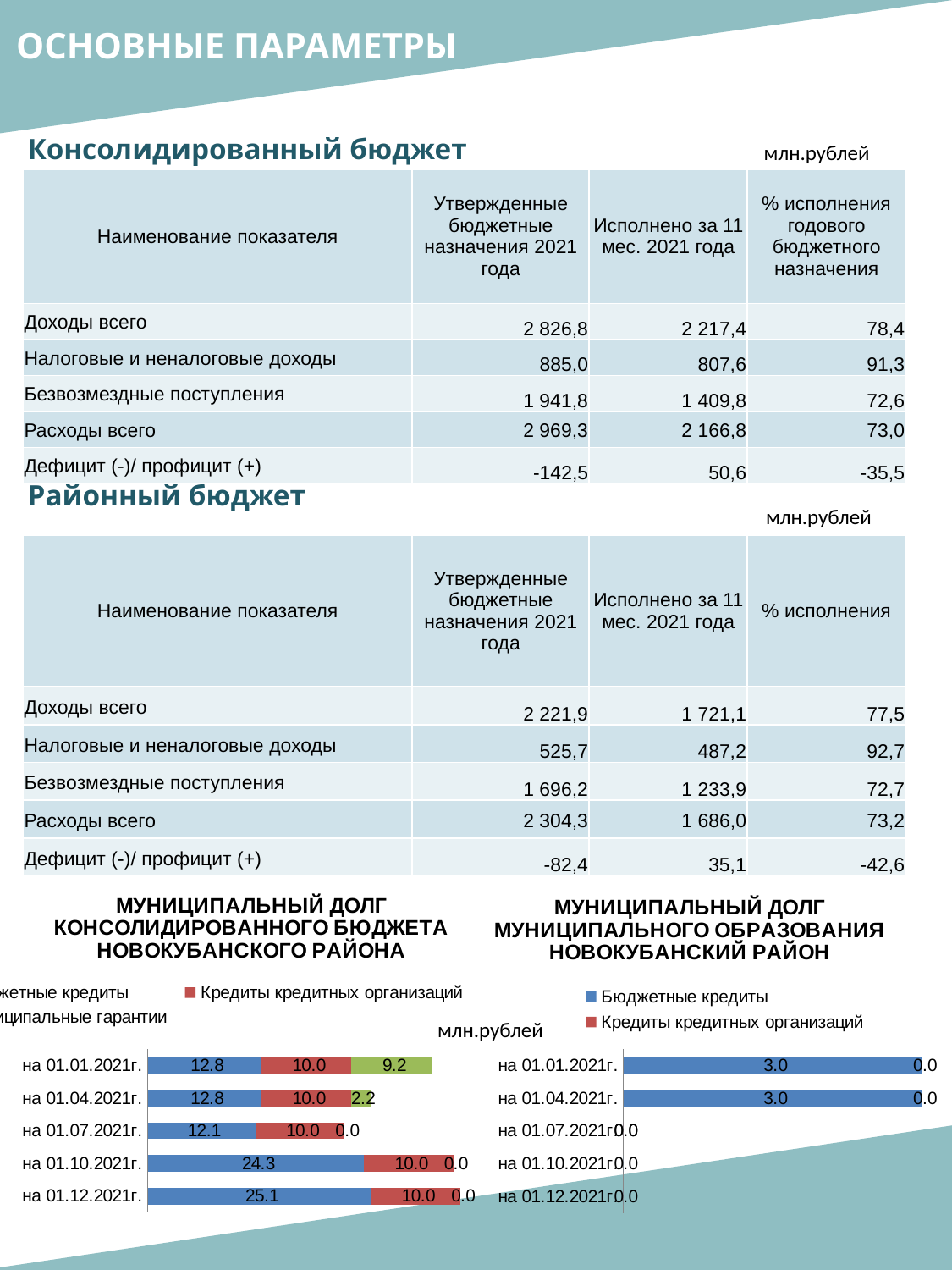
What kind of chart is 'МУНИЦИПАЛЬНЫЙ ДОЛГ МУНИЦИПАЛЬНОГО ОБРАЗОВАНИЯ НОВОКУБАНСКИЙ РАЙОН'? Bar chart In the chart 'МУНИЦИПАЛЬНЫЙ ДОЛГ КОНСОЛИДИРОВАННОГО БЮДЖЕТА НОВОКУБАНСКОГО РАЙОНА', what is the value of 'Кредиты кредитных организаций' on 01.12.2021? 10.0 In the chart 'МУНИЦИПАЛЬНЫЙ ДОЛГ МУНИЦИПАЛЬНОГО ОБРАЗОВАНИЯ НОВОКУБАНСКИЙ РАЙОН', what is the value of 'Кредиты кредитных организаций' on 01.01.2021? 0.0 In the chart 'МУНИЦИПАЛЬНЫЙ ДОЛГ КОНСОЛИДИРОВАННОГО БЮДЖЕТА НОВОКУБАНСКОГО РАЙОНА', what is the total of the stacked bar for 01.01.2021? 32.0 In the chart 'МУНИЦИПАЛЬНЫЙ ДОЛГ КОНСОЛИДИРОВАННОГО БЮДЖЕТА НОВОКУБАНСКОГО РАЙОНА', what is the value of the blue (Бюджетные кредиты) segment on 01.10.2021? 24.3 In the chart 'МУНИЦИПАЛЬНЫЙ ДОЛГ КОНСОЛИДИРОВАННОГО БЮДЖЕТА НОВОКУБАНСКОГО РАЙОНА', how many dates are shown? 5 In the chart 'МУНИЦИПАЛЬНЫЙ ДОЛГ КОНСОЛИДИРОВАННОГО БЮДЖЕТА НОВОКУБАНСКОГО РАЙОНА', what is the value of the green (Муниципальные гарантии) segment on 01.01.2021? 9.2 In the chart 'МУНИЦИПАЛЬНЫЙ ДОЛГ МУНИЦИПАЛЬНОГО ОБРАЗОВАНИЯ НОВОКУБАНСКИЙ РАЙОН', how many series does the legend list? 2 In the chart 'МУНИЦИПАЛЬНЫЙ ДОЛГ КОНСОЛИДИРОВАННОГО БЮДЖЕТА НОВОКУБАНСКОГО РАЙОНА', on which date is the blue (Бюджетные кредиты) value the lowest? на 01.07.2021г. In the chart 'МУНИЦИПАЛЬНЫЙ ДОЛГ МУНИЦИПАЛЬНОГО ОБРАЗОВАНИЯ НОВОКУБАНСКИЙ РАЙОН', what is the value of 'Бюджетные кредиты' on 01.04.2021? 3.0 In the chart 'МУНИЦИПАЛЬНЫЙ ДОЛГ КОНСОЛИДИРОВАННОГО БЮДЖЕТА НОВОКУБАНСКОГО РАЙОНА', what is the difference between the blue (Бюджетные кредиты) values on 01.12.2021 and 01.01.2021? 12.3 In the chart 'МУНИЦИПАЛЬНЫЙ ДОЛГ КОНСОЛИДИРОВАННОГО БЮДЖЕТА НОВОКУБАНСКОГО РАЙОНА', what is the total of the stacked bar for 01.12.2021? 35.1